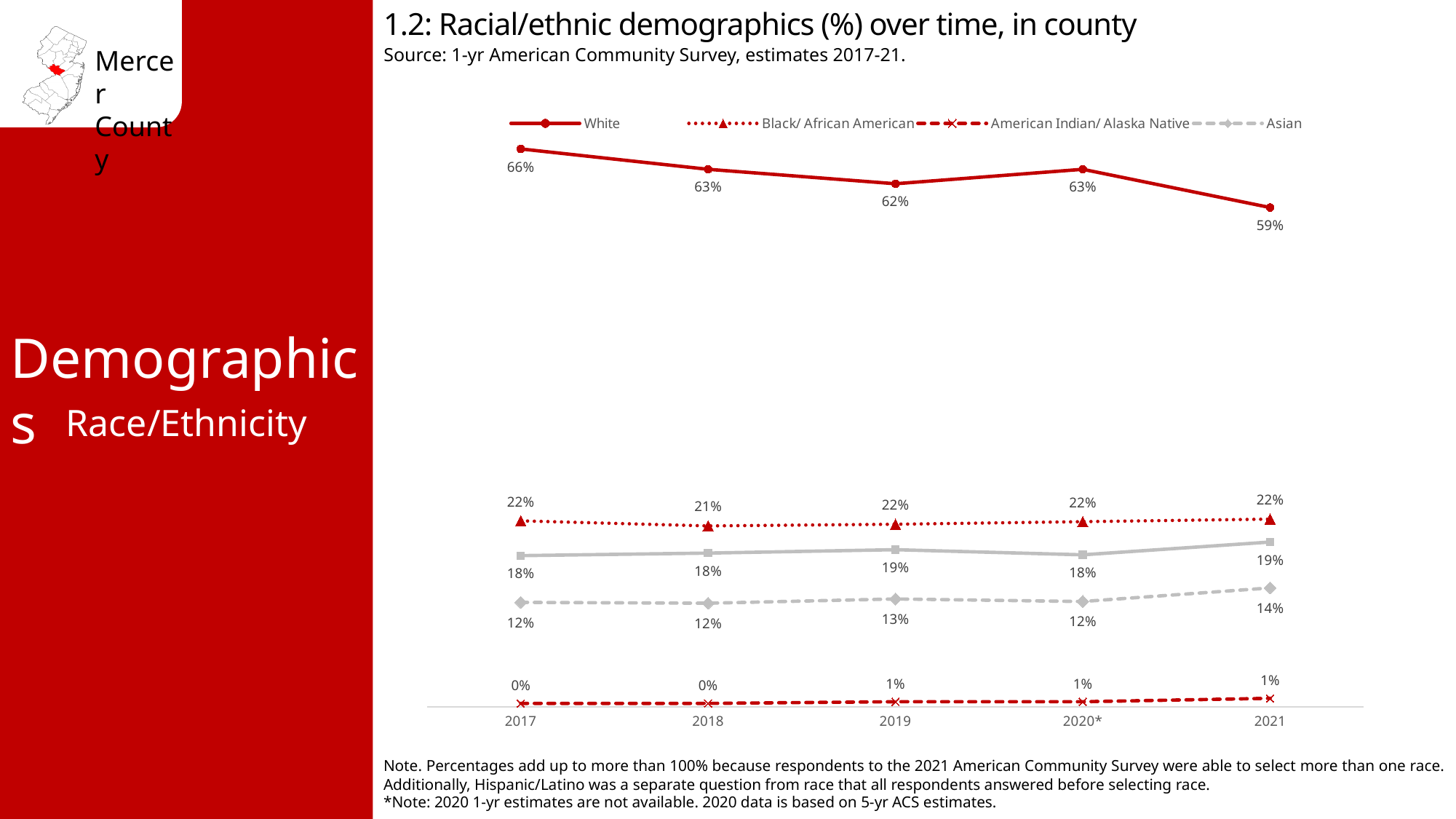
In which year is the White share lowest? 2021 What kind of chart is shown on the slide? line chart What is the value for Asian in 2021? 14% In 2019, which is larger: the Black/ African American share or the Asian share? Black/ African American What is the value for Black/ African American in 2018? 21% What is the value for American Indian/ Alaska Native in 2017? 0% In which year is the White share highest? 2017 How many years are shown on the x axis? 5 What is the value for White in 2017? 66% What is the value for White in 2021? 59% Does the White share generally rise or fall from 2017 to 2021? fall By how many percentage points did the White share fall from 2017 to 2021? 7